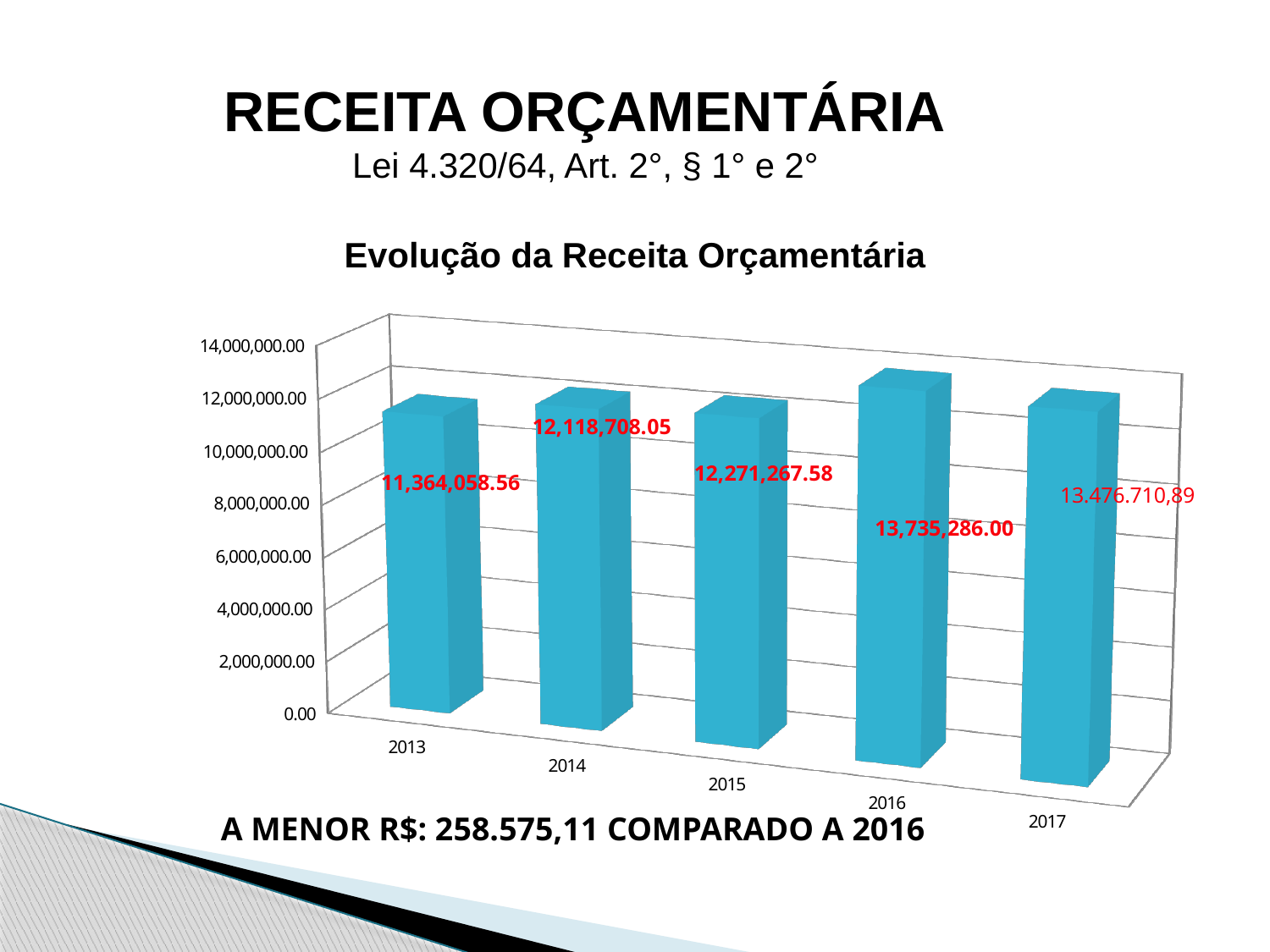
What is the value for 2013 in the chart? 11,364,058.56 How many years are shown in the chart? 5 Is the value for 2016 greater or less than 12,000,000.00? greater What is the value for 2016 in the chart? 13,735,286.00 What is the title of the chart? Evolução da Receita Orçamentária Which is larger, the value for 2016 or the value for 2017? 2016 Which year has the highest value in the chart? 2016 Which year has the lowest value in the chart? 2013 What is the difference between the values for 2014 and 2013? 754,649.49 What kind of chart is shown on the slide? bar chart What is the value for 2017 in the chart? 13.476.710,89 What is the difference between the values for 2015 and 2014? 152,559.53